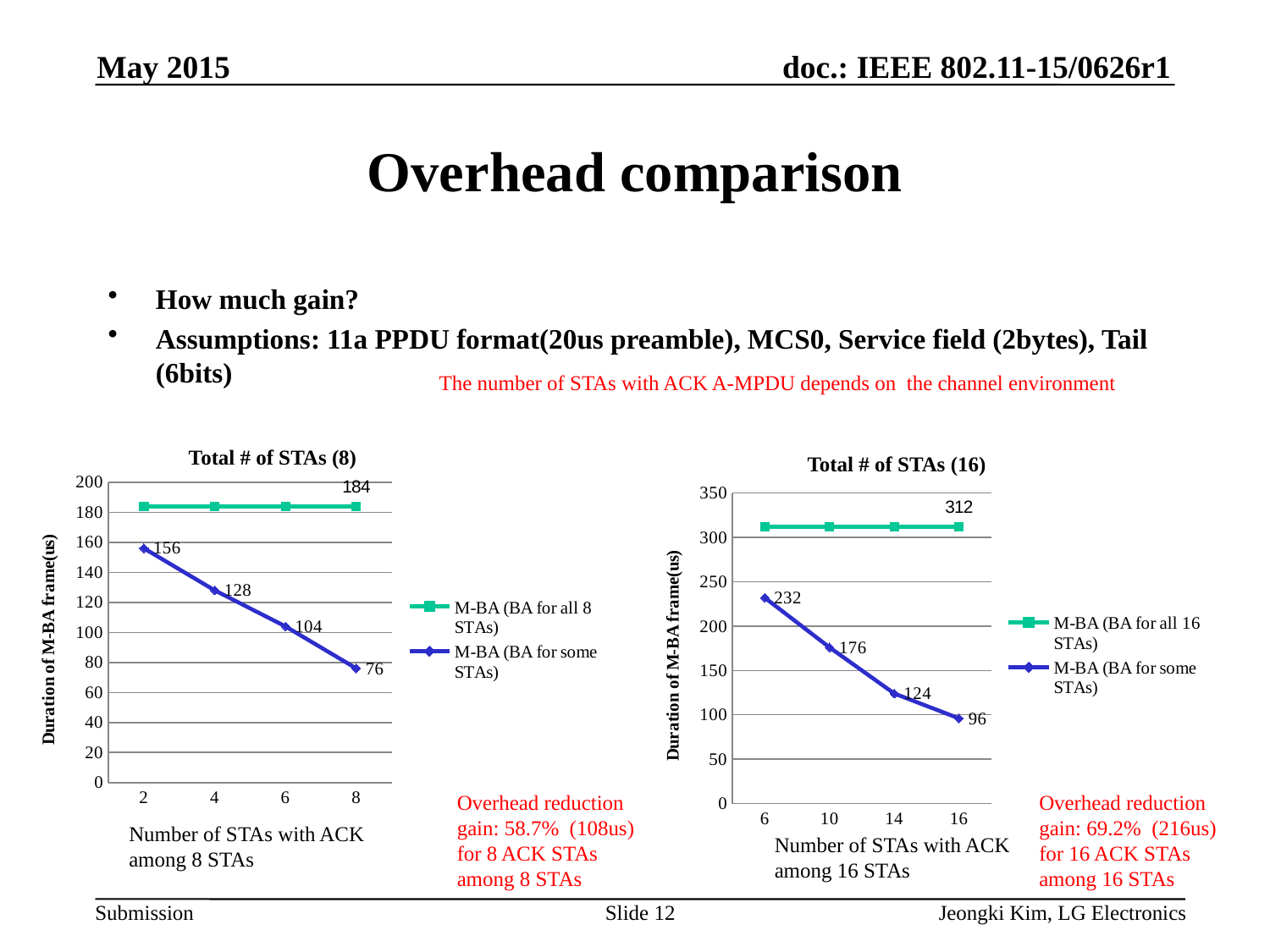
In the 'Total # of STAs (8)' chart, what value is labelled on the 'M-BA (BA for all 8 STAs)' series at 8 STAs with ACK? 184 In the 'Total # of STAs (16)' chart, what value is labelled on the 'M-BA (BA for all 16 STAs)' series at 16 STAs with ACK? 312 In the 'Total # of STAs (8)' chart, what is the value of the 'M-BA (BA for some STAs)' series when the number of STAs with ACK is 2? 156 In the 'Total # of STAs (16)' chart, what is the value of the 'M-BA (BA for some STAs)' series at 10 STAs with ACK? 176 In the 'Total # of STAs (8)' chart, what is the value of the 'M-BA (BA for some STAs)' series at 8 STAs with ACK? 76 In the 'Total # of STAs (16)' chart, what is the value of the 'M-BA (BA for some STAs)' series at 14 STAs with ACK? 124 In the 'Total # of STAs (8)' chart, does the 'M-BA (BA for some STAs)' series rise or fall as the number of STAs with ACK increases? fall What type of chart is the 'Total # of STAs (8)' chart? line chart In the 'Total # of STAs (8)' chart, what is the difference between the 'M-BA (BA for all 8 STAs)' value and the 'M-BA (BA for some STAs)' value at 8 STAs with ACK? 108 In the 'Total # of STAs (16)' chart, what is the difference between the 'M-BA (BA for some STAs)' values at 6 and 16 STAs with ACK? 136 How many series does the legend of the 'Total # of STAs (16)' chart list? 2 In the 'Total # of STAs (16)' chart, which is larger at 6 STAs with ACK: the 'M-BA (BA for all 16 STAs)' series or the 'M-BA (BA for some STAs)' series? M-BA (BA for all 16 STAs)